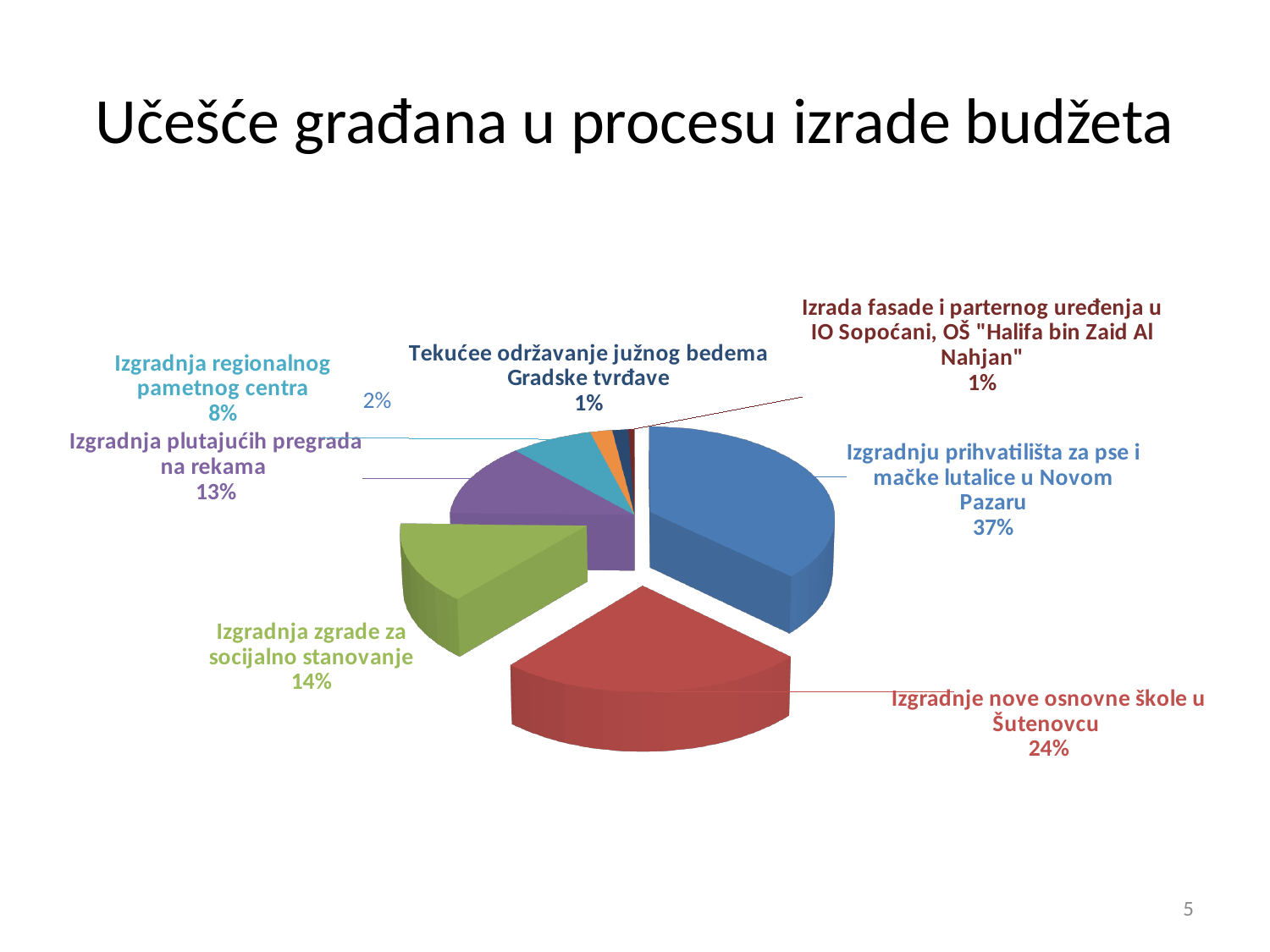
What kind of chart is shown on the slide? pie chart How many slices does the pie chart have? 8 What percentage is shown for "Izgradnja zgrade za socijalno stanovanje"? 14% What is the difference in percentage points between "Izgradnju prihvatilišta za pse i mačke lutalice u Novom Pazaru" and "Izgradnje nove osnovne škole u Šutenovcu"? 13 percentage points Which has a larger share: "Izgradnja zgrade za socijalno stanovanje" or "Izgradnja plutajućih pregrada na rekama"? Izgradnja zgrade za socijalno stanovanje What percentage is shown for "Izgradnje nove osnovne škole u Šutenovcu"? 24% What percentage is shown for "Izgradnja regionalnog pametnog centra"? 8% What percentage is shown for "Izgradnja plutajućih pregrada na rekama"? 13% What share of the pie does "Izgradnju prihvatilišta za pse i mačke lutalice u Novom Pazaru" have? 37% Which category has the largest share of the pie? Izgradnju prihvatilišta za pse i mačke lutalice u Novom Pazaru What is the title of the slide containing the pie chart? Učešće građana u procesu izrade budžeta What percentage is shown for "Tekućee održavanje južnog bedema Gradske tvrđave"? 1%